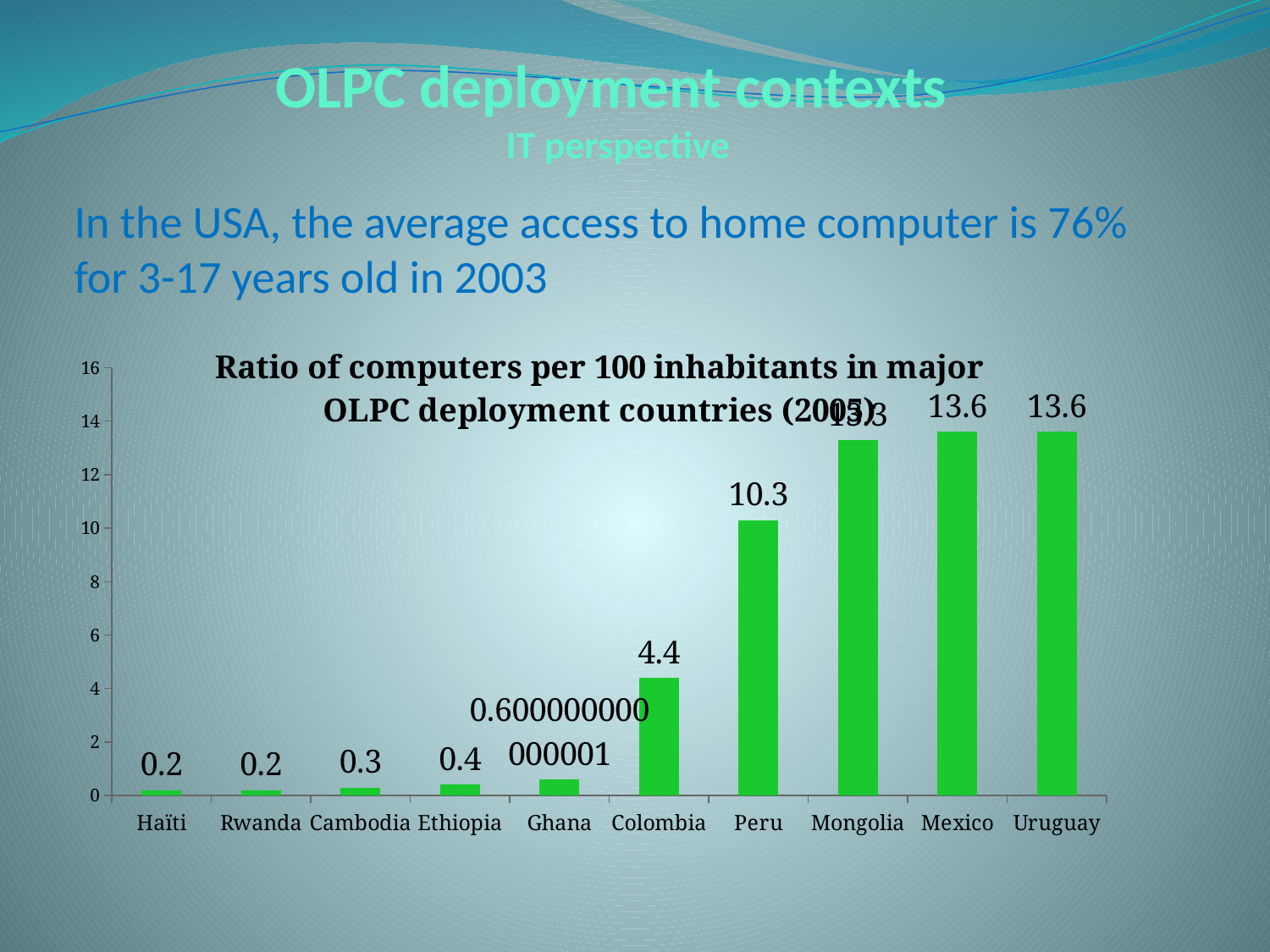
How many countries are shown in the chart? 10 What kind of chart is shown on the slide? bar chart What is the difference between the values for Peru and Colombia? 5.9 What is the value for Peru in the chart? 10.3 Do the values generally rise or fall from left to right along the x axis? rise Which has a larger value, Peru or Colombia? Peru Is the value for Ghana greater or less than 2? less Is the value for Mongolia greater or less than 12? greater What is the value for Cambodia in the chart? 0.3 What is the value for Mexico in the chart? 13.6 What is the value for Colombia in the chart? 4.4 What is the value for Ethiopia in the chart? 0.4